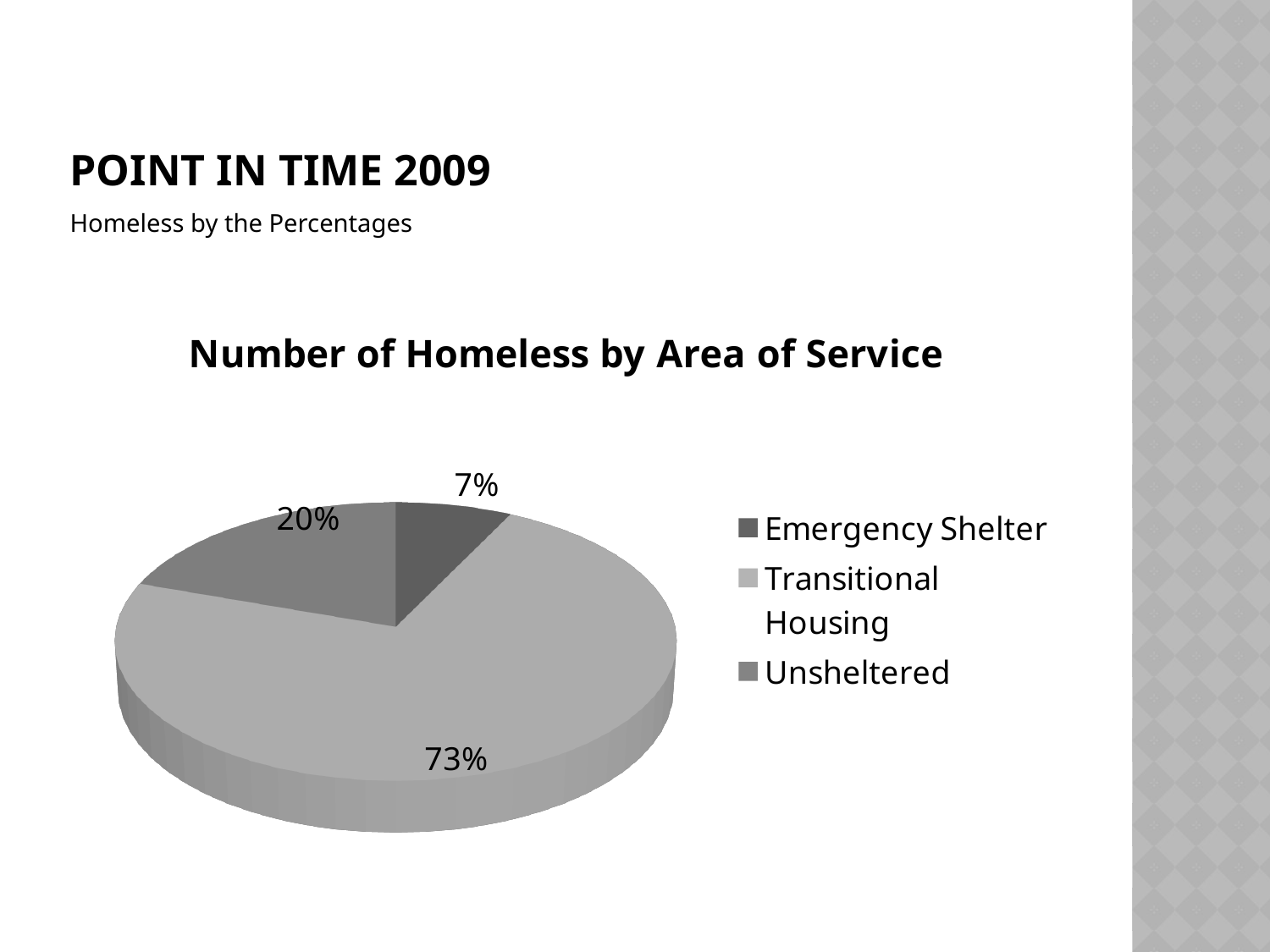
What is the difference in percentage points between Transitional Housing and Unsheltered? 53 Which is larger, the share for Unsheltered or the share for Emergency Shelter? Unsheltered What percentage of the pie is Unsheltered? 20% Which category has the smallest share of the pie? Emergency Shelter What percentage of the pie is Transitional Housing? 73% What percentage of the pie is Emergency Shelter? 7% How many slices does the pie chart have? 3 How many entries does the legend list? 3 Which category has the largest share of the pie? Transitional Housing What kind of chart is shown on the slide? Pie chart Which legend entry is listed first? Emergency Shelter What is the title of the chart? Number of Homeless by Area of Service